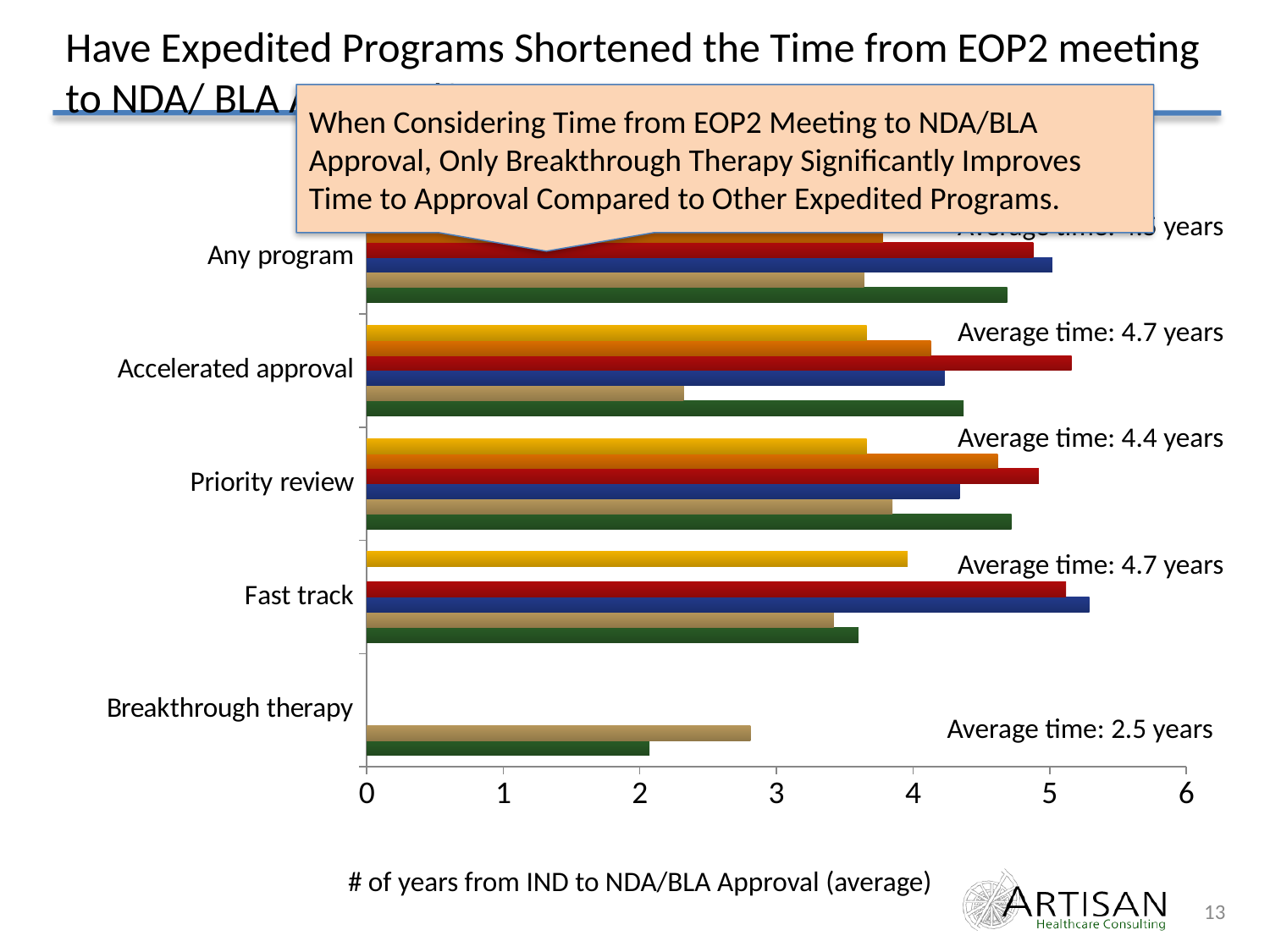
What kind of chart is shown on the slide? bar chart What is the average time shown for Accelerated approval? 4.7 years Is the value of the tan bar for Breakthrough therapy greater or less than 3? less Which program has the lowest average time annotated on the chart? Breakthrough therapy Which has the larger annotated average time, Accelerated approval or Priority review? Accelerated approval How many program categories are shown on the y axis of the chart? 5 What is the average time shown for Breakthrough therapy? 2.5 years Is the value of the longest bar for Fast track greater or less than 5? greater What is the average time shown for Fast track? 4.7 years What is the difference between the annotated average time for Accelerated approval and for Breakthrough therapy? 2.2 years What is the average time shown for Priority review? 4.4 years What is the label of the x axis of the chart? # of years from IND to NDA/BLA Approval (average)